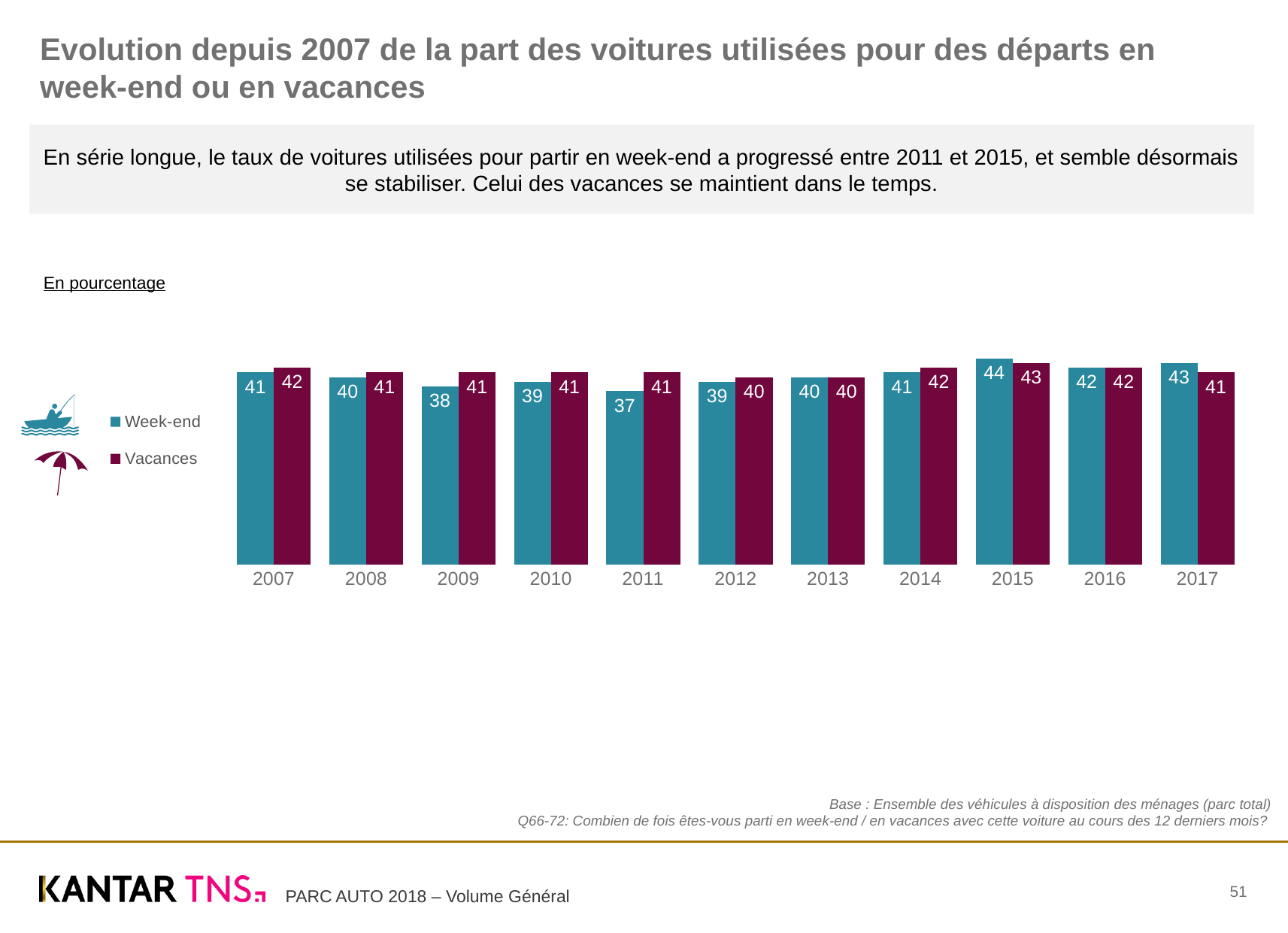
How many years are shown on the x axis? 11 In 2017, which series has the larger value, Week-end or Vacances? Week-end What is the Vacances value for 2015? 43 What is the Week-end value for 2017? 43 In which year is the Week-end value highest? 2015 Does the Week-end value rise or fall from 2011 to 2015? Rise What are the two legend entries of the chart? Week-end and Vacances How many series does the legend list? 2 What is the difference between the Week-end values for 2015 and 2011? 7 In which year is the Week-end value lowest? 2011 What kind of chart is shown on the slide? Bar chart What is the Week-end value for 2011? 37